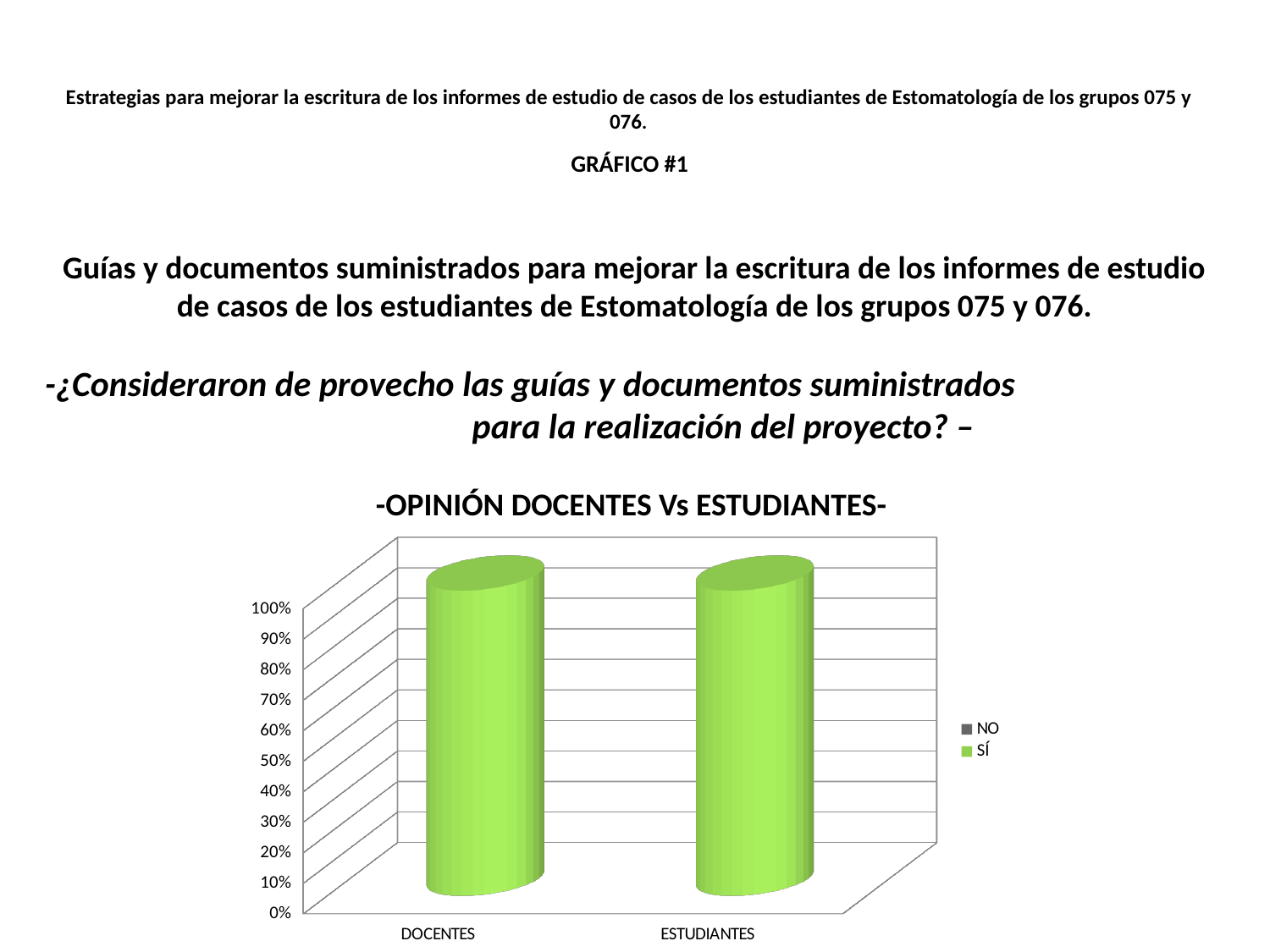
Which entries appear in the chart legend? NO and SÍ Is the value for ESTUDIANTES greater or less than 50%? greater Is the value for DOCENTES greater or less than 20%? greater Is the value for DOCENTES greater or less than 80%? greater What are the two categories shown on the x axis of the chart? DOCENTES and ESTUDIANTES How many categories are shown on the x axis of the chart? 2 What kind of chart is shown on the slide? bar chart How many series does the chart legend list? 2